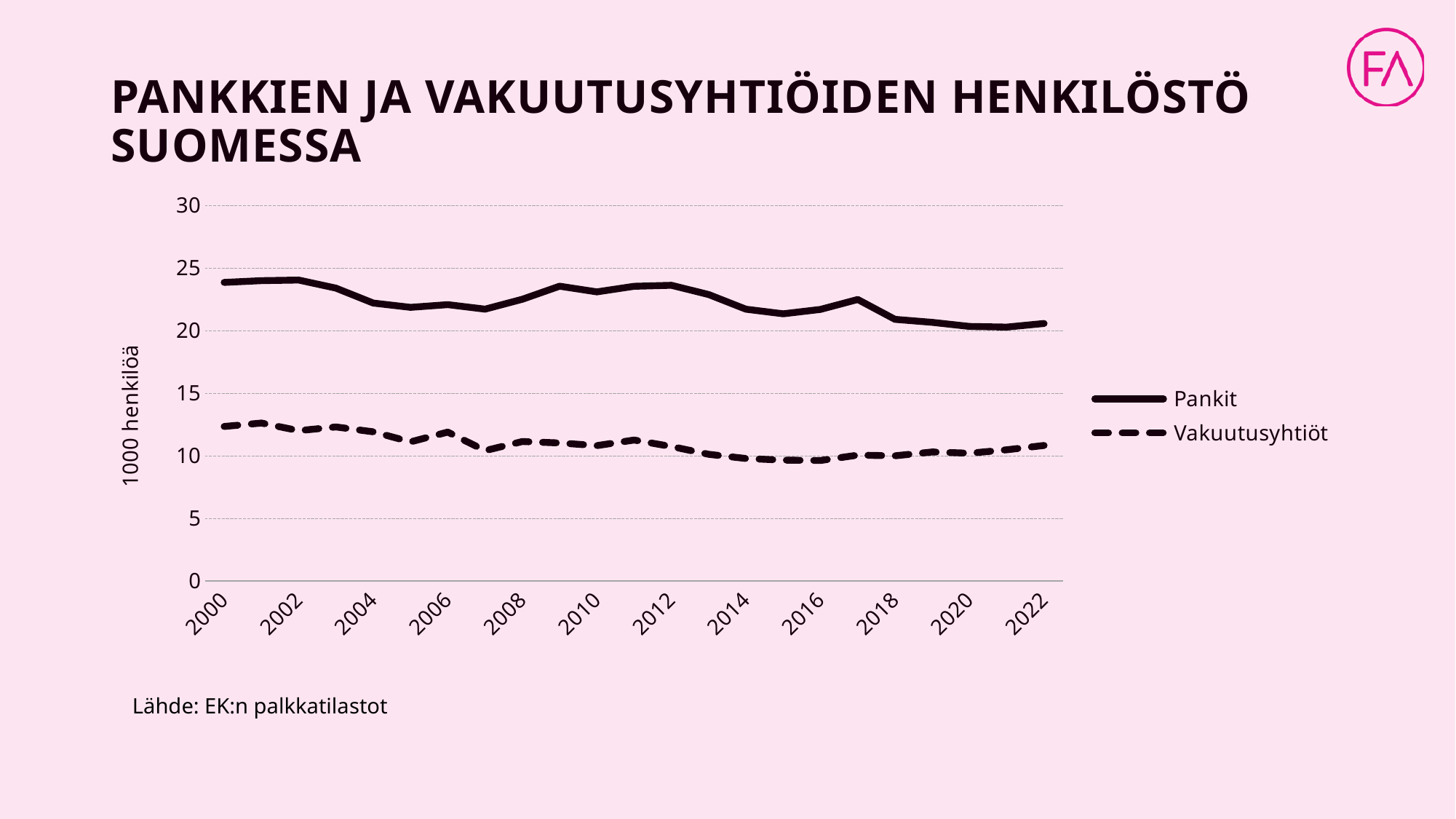
What kind of chart is shown on the slide? line chart Does the Pankit line overall rise or fall from 2000 to 2022? fall Is the value for Vakuutusyhtiöt in 2000 greater or less than 10? greater In 2010, which series has the larger value, Pankit or Vakuutusyhtiöt? Pankit Which two series are listed in the legend? Pankit and Vakuutusyhtiöt How many series does the legend list? 2 Is the value for Pankit in 2012 greater or less than 20? greater Is the value for Pankit in 2000 greater or less than 20? greater What is the label on the vertical axis? 1000 henkilöä How many year labels are shown on the x axis? 12